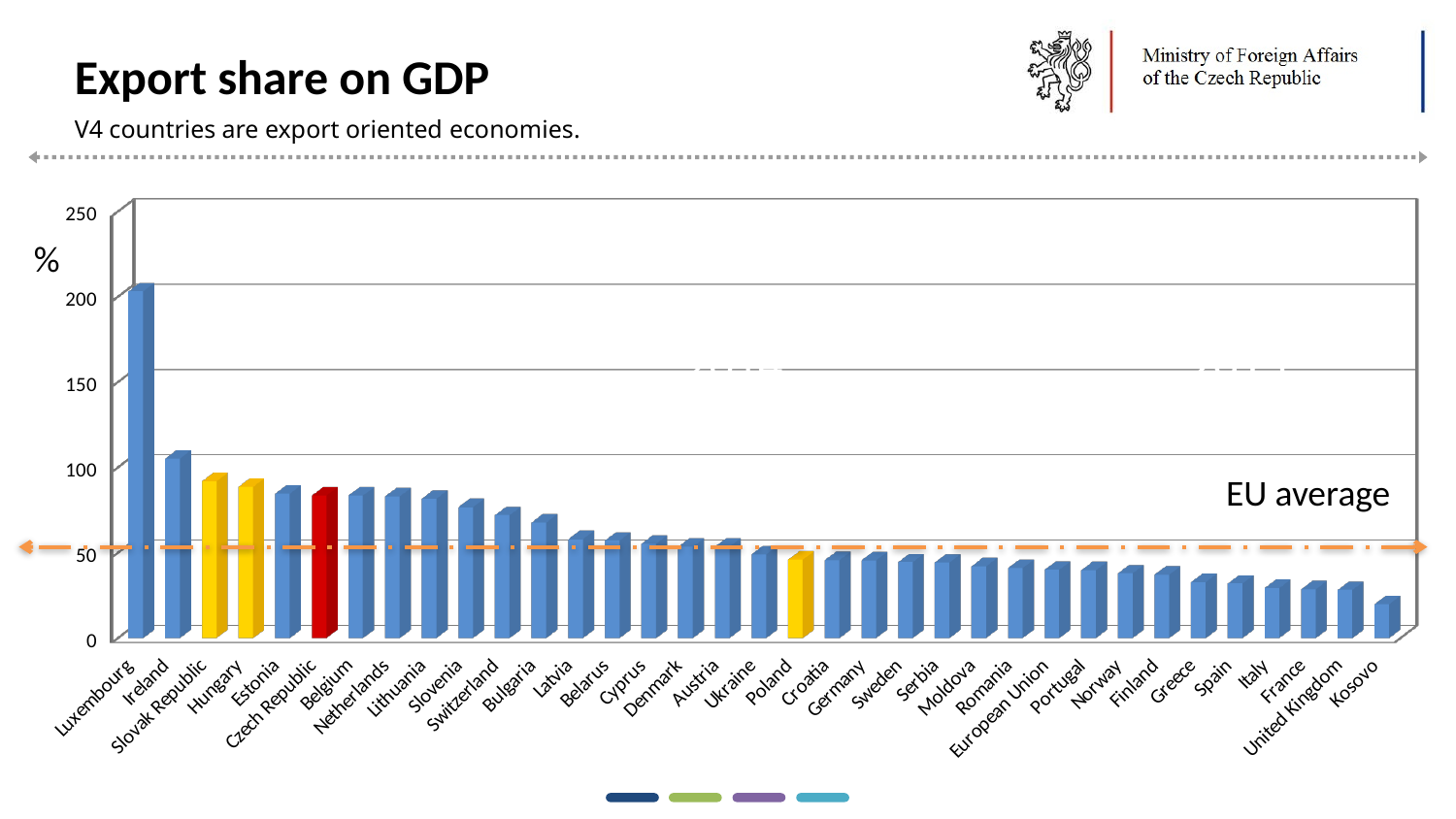
What does the orange dashed horizontal line across the chart represent? EU average Which country has the lowest export share on GDP in the chart? Kosovo Which has a larger export share on GDP, Luxembourg or Ireland? Luxembourg How many countries or regions are shown on the x axis of the chart? 35 What kind of chart is shown on the slide? bar chart Is the value for Italy greater or less than 50? less Is the value for Hungary greater or less than 50? greater Do the bar values rise or fall moving from left to right along the x axis? fall Is the value for Kosovo greater or less than 50? less Which has a larger export share on GDP, Slovak Republic or Poland? Slovak Republic Which country has the highest export share on GDP in the chart? Luxembourg